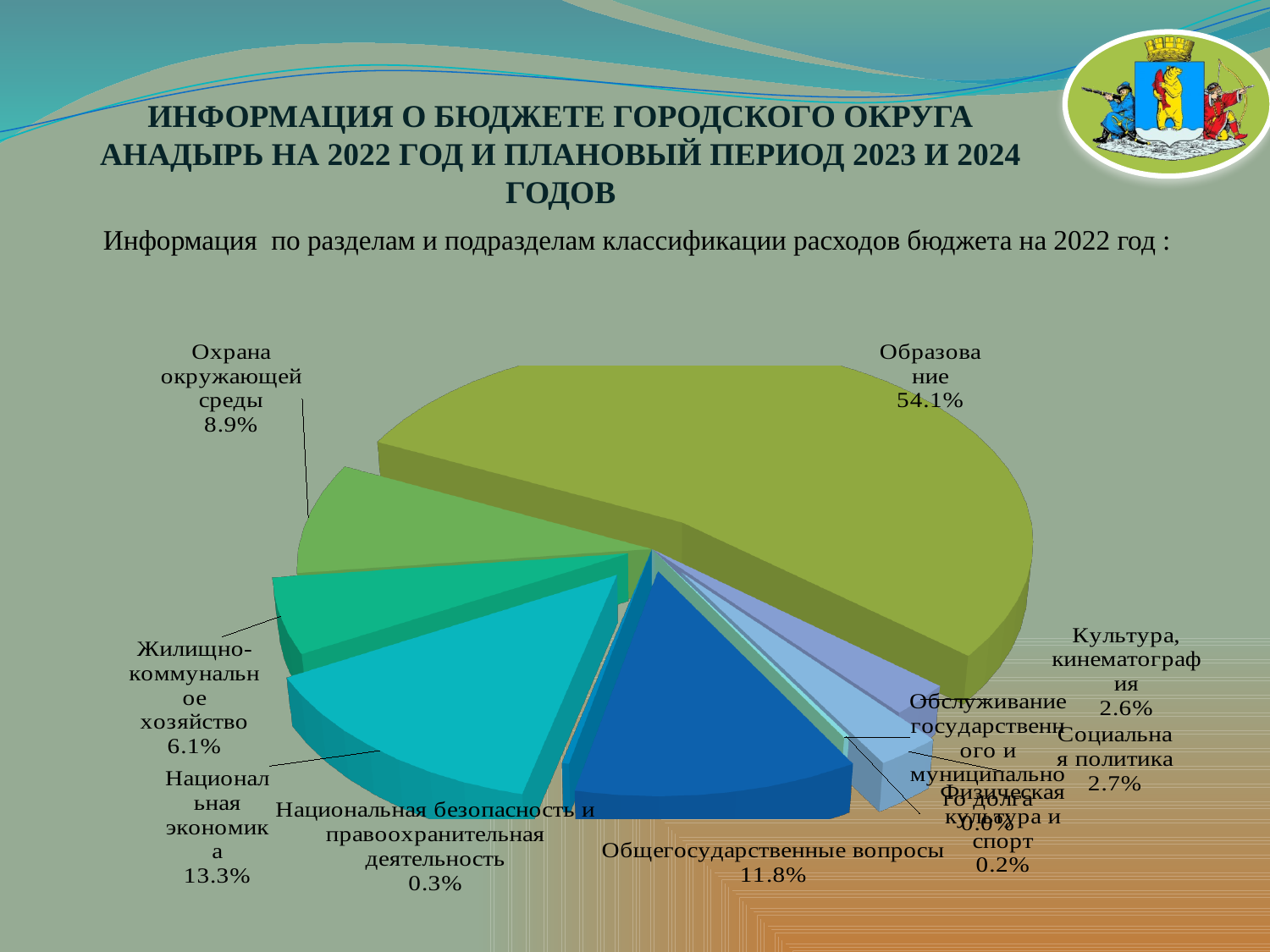
What kind of chart is shown on the slide? pie chart What is the value shown for Жилищно-коммунальное хозяйство? 6.1% What is the value shown for Национальная экономика? 13.3% Which category has the smallest share of the pie? Обслуживание государственного и муниципального долга What is the difference between the shares for Образование and Национальная экономика? 40.8% Which category has the largest share of the pie? Образование What is the value shown for Общегосударственные вопросы? 11.8% Which is larger, the share for Национальная экономика or the share for Общегосударственные вопросы? Национальная экономика How many categories are shown in the pie chart? 10 What is the value shown for Охрана окружающей среды? 8.9% What is the value shown for Социальная политика? 2.7% What share of the budget expenditure goes to Образование? 54.1%